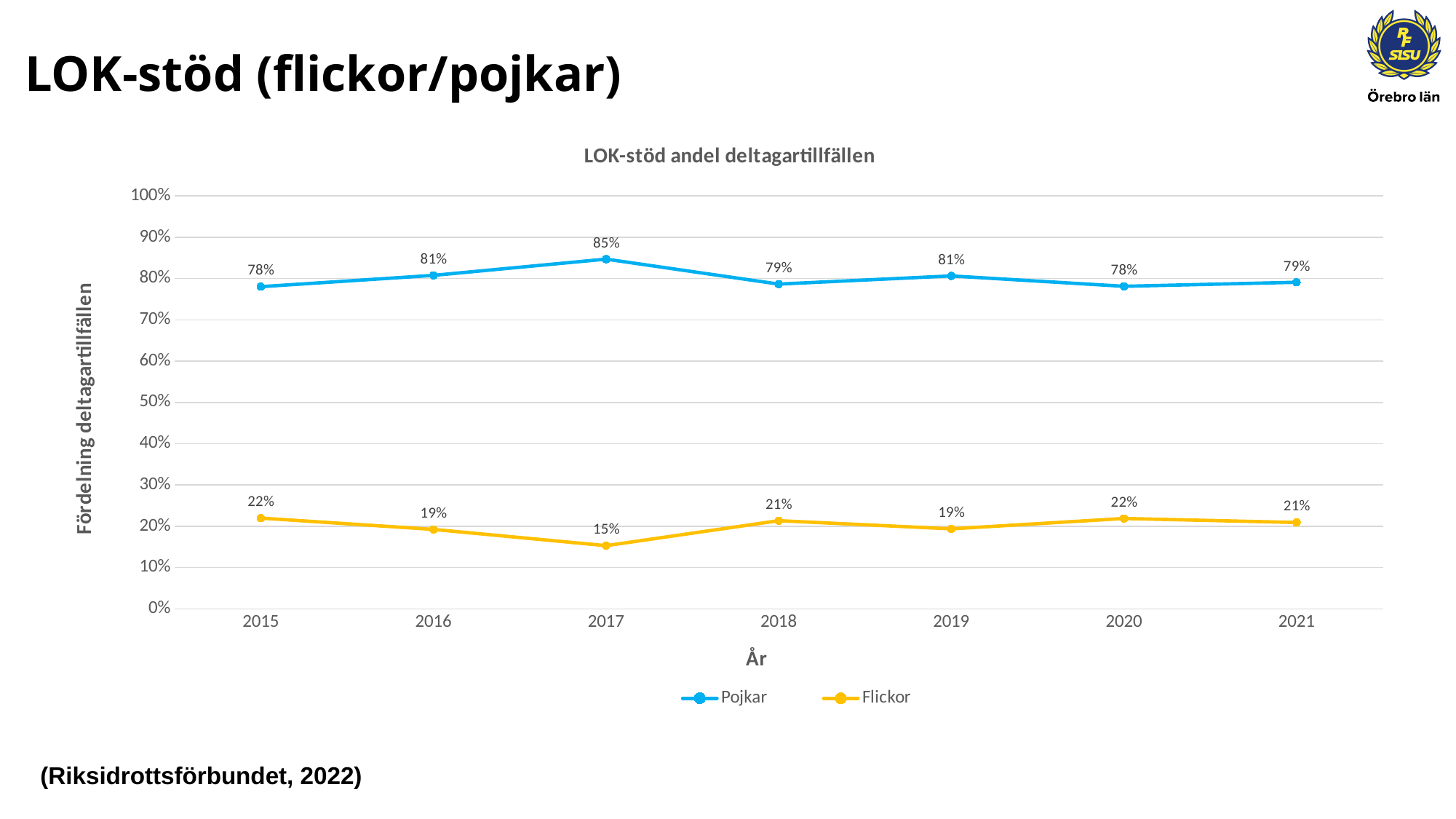
What is the difference between the Pojkar and Flickor values in 2017? 70% What is the value for Flickor in 2017? 15% What kind of chart is shown on the slide? Line chart What is the value for Pojkar in 2021? 79% In which year is the Pojkar value highest? 2017 What is the value for Pojkar in 2017? 85% What is the value for Flickor in 2020? 22% How many years are shown on the x axis? 7 In which year is the Flickor value lowest? 2017 Which is larger in 2019, the Pojkar value or the Flickor value? Pojkar What is the title of the chart? LOK-stöd andel deltagartillfällen How many series does the legend list? 2